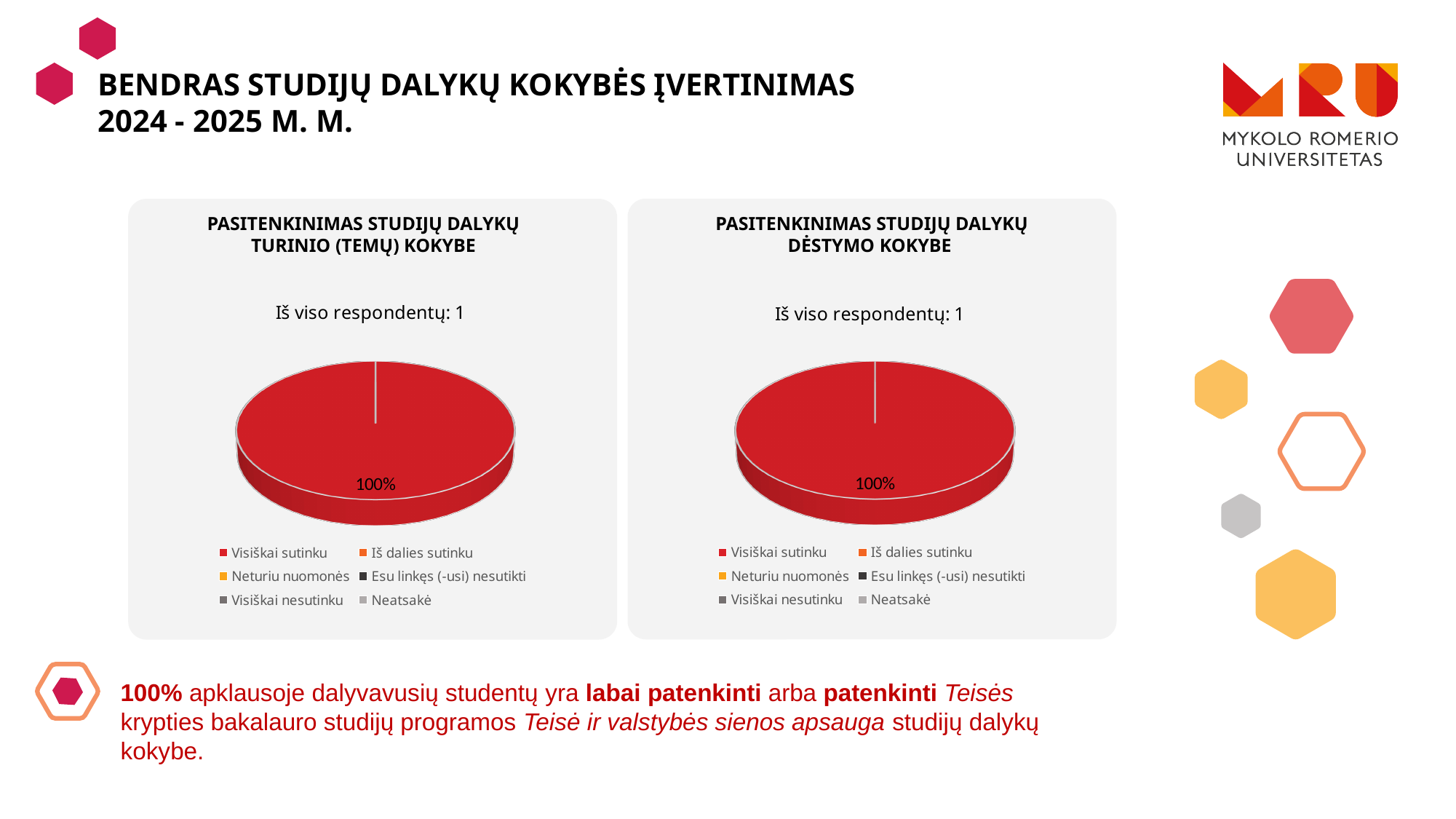
What colour is the 'Neturiu nuomonės' legend marker in the 'PASITENKINIMAS STUDIJŲ DALYKŲ TURINIO (TEMŲ) KOKYBE' chart? Yellow/orange How many respondents are reported for the 'PASITENKINIMAS STUDIJŲ DALYKŲ TURINIO (TEMŲ) KOKYBE' chart? 1 What kind of chart is used in the 'PASITENKINIMAS STUDIJŲ DALYKŲ TURINIO (TEMŲ) KOKYBE' panel? Pie chart How many respondents are reported for the 'PASITENKINIMAS STUDIJŲ DALYKŲ DĖSTYMO KOKYBE' chart? 1 How many entries does the legend list in the 'PASITENKINIMAS STUDIJŲ DALYKŲ TURINIO (TEMŲ) KOKYBE' chart? 6 In the 'PASITENKINIMAS STUDIJŲ DALYKŲ TURINIO (TEMŲ) KOKYBE' chart, which legend category does the single red slice correspond to? Visiškai sutinku In the 'PASITENKINIMAS STUDIJŲ DALYKŲ DĖSTYMO KOKYBE' chart, which category has the largest share? Visiškai sutinku In the 'PASITENKINIMAS STUDIJŲ DALYKŲ TURINIO (TEMŲ) KOKYBE' chart, what share of the pie is labelled? 100% How many pie charts are shown on the slide? 2 In the 'PASITENKINIMAS STUDIJŲ DALYKŲ DĖSTYMO KOKYBE' chart, what share of the pie is labelled? 100% In the 'PASITENKINIMAS STUDIJŲ DALYKŲ DĖSTYMO KOKYBE' chart, which legend category does the single red slice correspond to? Visiškai sutinku How many entries does the legend list in the 'PASITENKINIMAS STUDIJŲ DALYKŲ DĖSTYMO KOKYBE' chart? 6